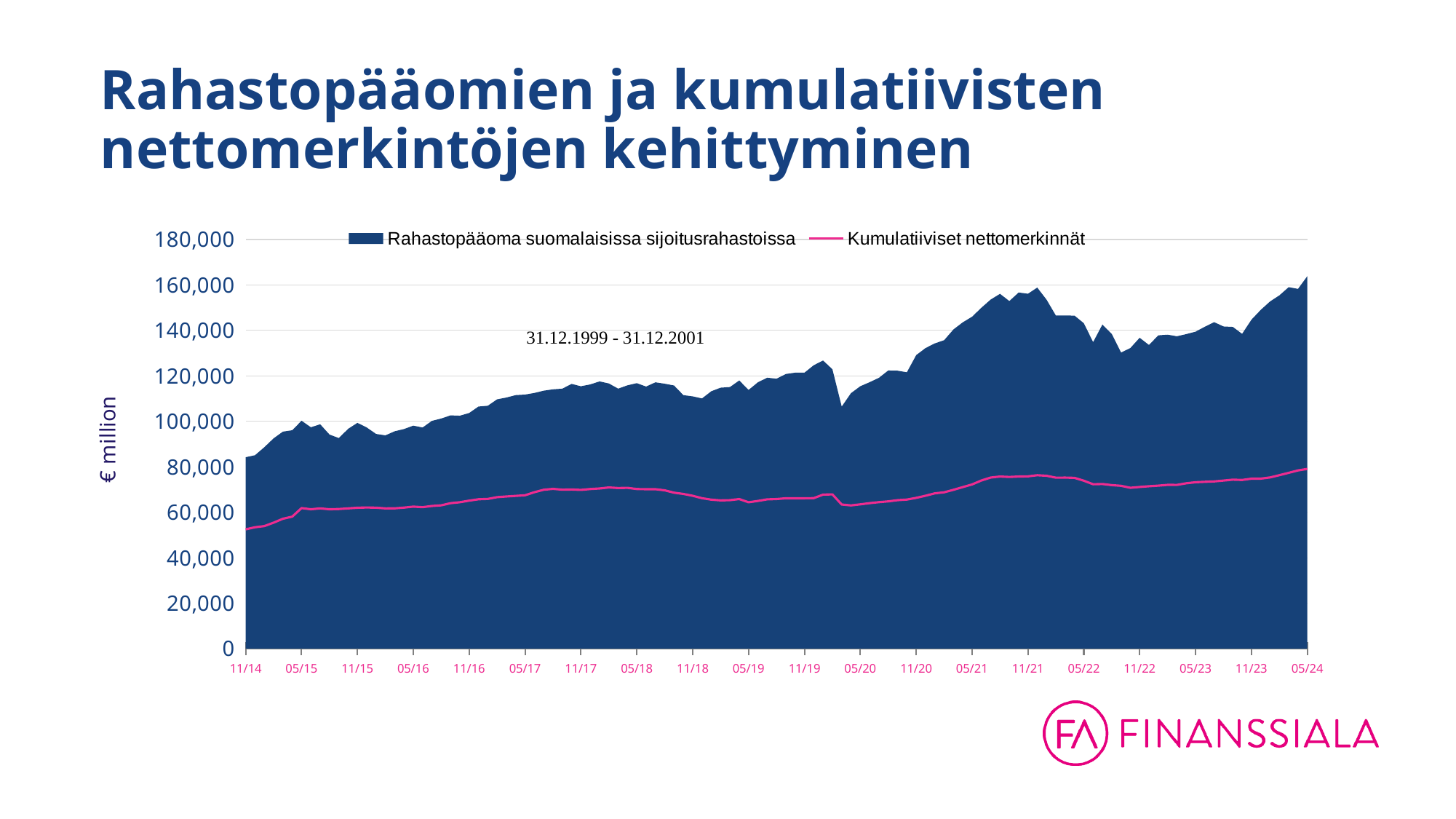
Which series has the higher value at 05/24, Rahastopääoma suomalaisissa sijoitusrahastoissa or Kumulatiiviset nettomerkinnät? Rahastopääoma suomalaisissa sijoitusrahastoissa What is the label of the y axis? € million Is the value of Rahastopääoma suomalaisissa sijoitusrahastoissa at 11/14 greater or less than 100,000? less Is the value of Kumulatiiviset nettomerkinnät at 05/24 greater or less than 100,000? less What kind of chart is shown on the slide? Area chart with a line series How many series does the chart legend list? 2 What is the highest value shown on the y axis? 180,000 Is the value of Kumulatiiviset nettomerkinnät at 11/14 greater or less than 60,000? less Does the Kumulatiiviset nettomerkinnät series rise or fall overall from 11/14 to 05/24? rise How many date labels are shown on the x axis? 20 Does the Rahastopääoma suomalaisissa sijoitusrahastoissa series rise or fall overall from 11/14 to 05/24? rise